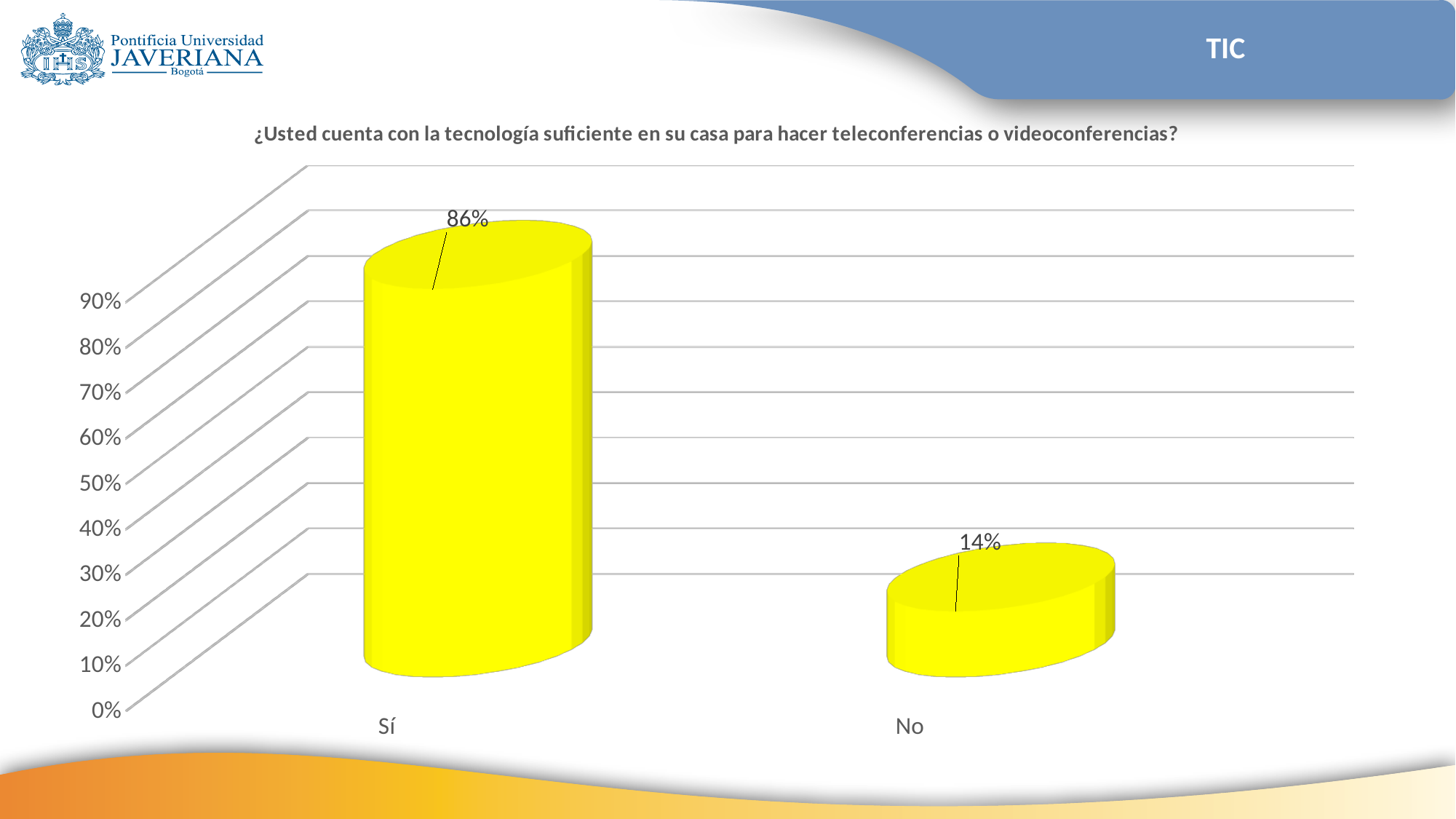
What kind of chart is shown on the slide? bar chart What is the value for Sí? 86% Which category has the highest value? Sí Which is larger, the value for Sí or the value for No? Sí What is the difference between the values for Sí and No? 72% Is the value for No greater or less than 20%? less What is the title of the chart? ¿Usted cuenta con la tecnología suficiente en su casa para hacer teleconferencias o videoconferencias? Which category has the lowest value? No What colour are the bars in the chart? yellow What is the value for No? 14% Is the value for Sí greater or less than 50%? greater How many categories are shown on the x axis? 2